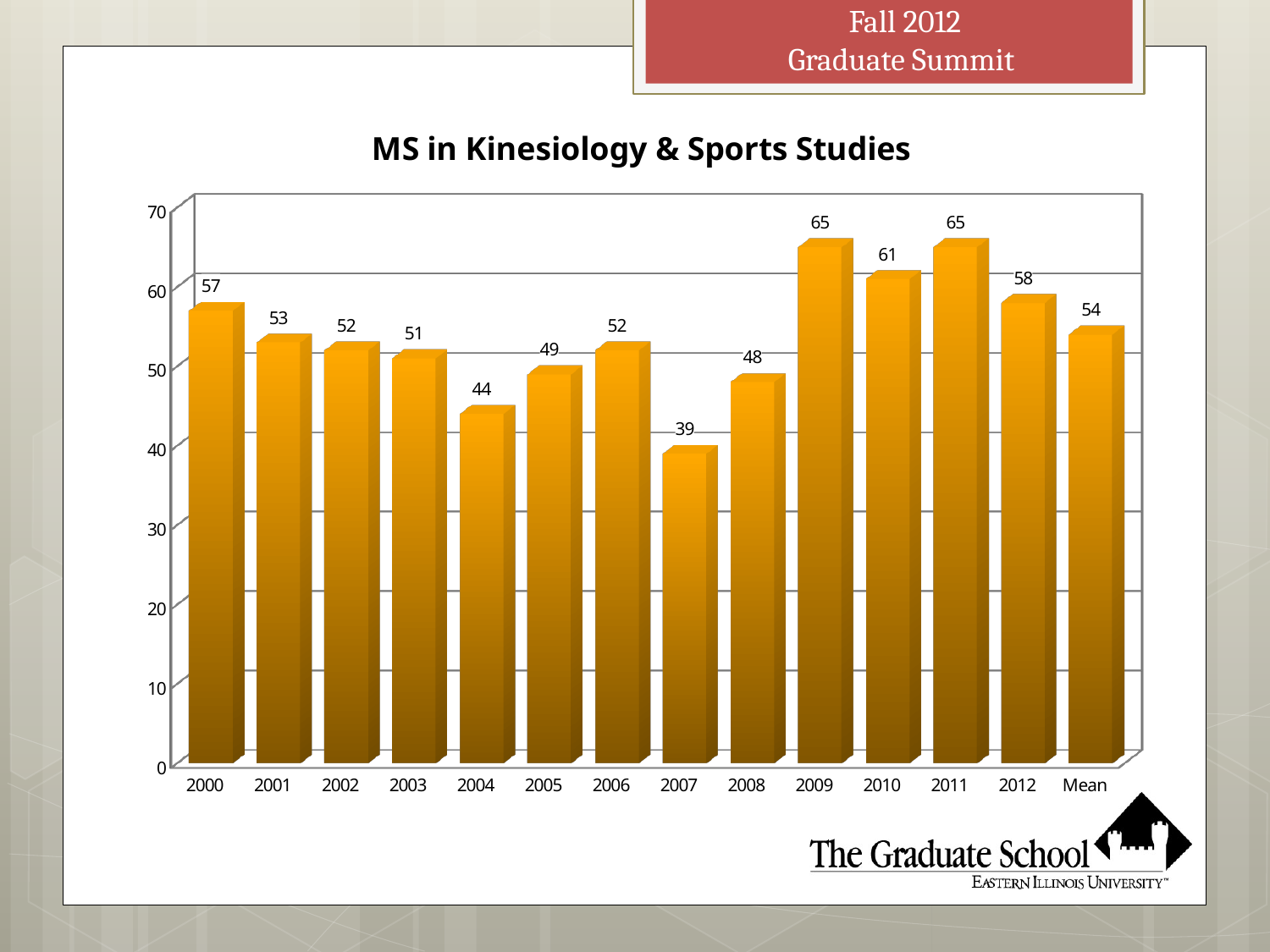
What is the value for 2007? 39 What is the difference between the values for 2009 and 2007? 26 Which is larger, the value for 2000 or the value for 2012? 2012 Which year has the lowest value? 2007 How many bars are shown in the chart, including the Mean bar? 14 What is the highest value shown in the chart? 65 What is the title of the chart? MS in Kinesiology & Sports Studies What kind of chart is shown on the slide? bar chart What is the Mean value shown in the chart? 54 What is the difference between the value for 2011 and the Mean? 11 Do the values rise or fall from 2007 to 2009? rise What is the value for 2010? 61